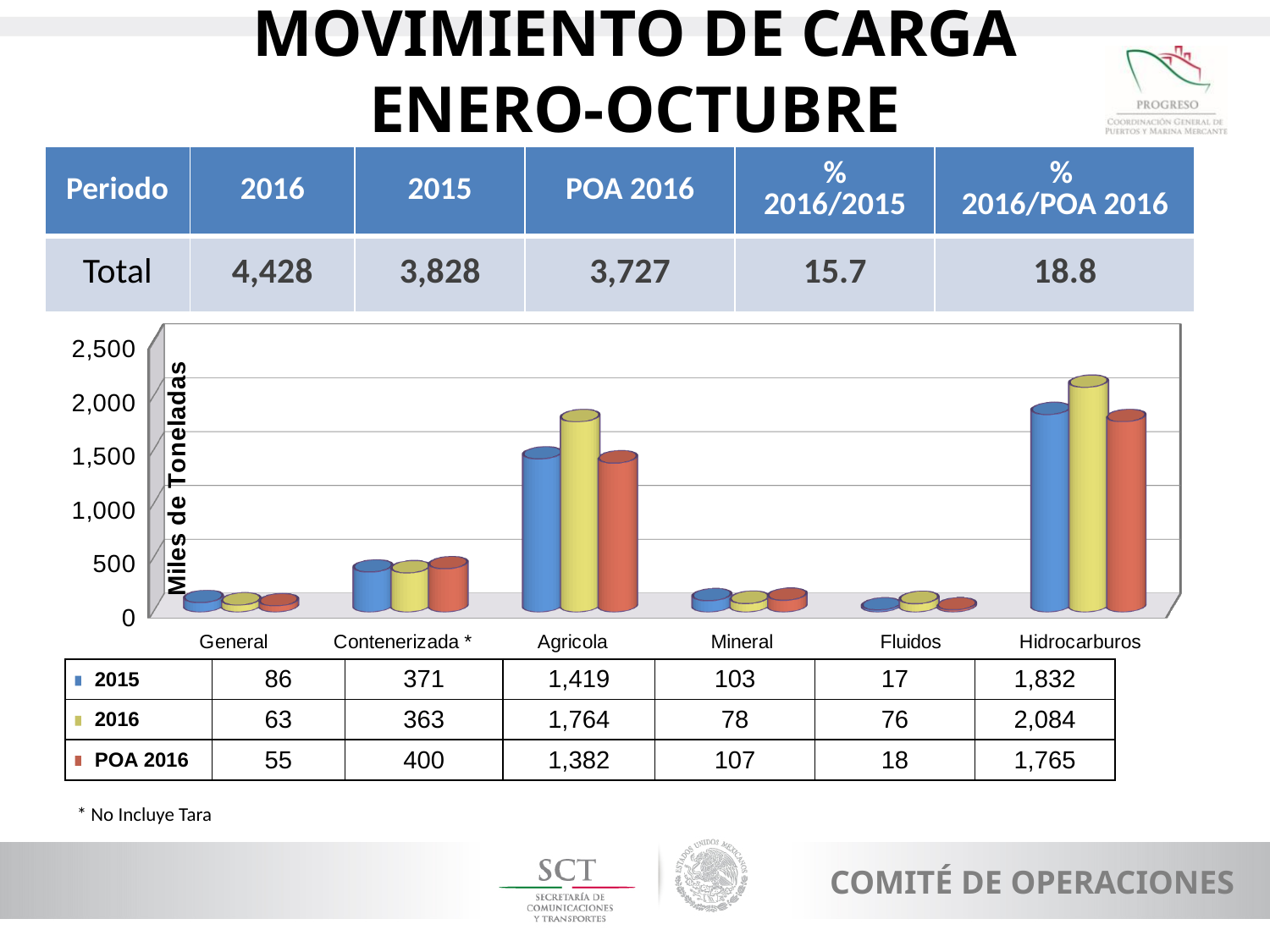
Which is larger for Mineral, the 2015 value or the 2016 value? 2015 What is the 2015 value for Fluidos? 17 What kind of chart is shown on the slide? bar chart How many series does the chart's legend list? 3 What is the 2016 value for Agricola? 1,764 How many categories are shown on the x axis of the chart? 6 Which category has the highest 2016 value? Hidrocarburos What is the POA 2016 value for Contenerizada *? 400 What is the difference between the 2016 and 2015 values for Hidrocarburos? 252 What is the label on the vertical axis of the chart? Miles de Toneladas Is the 2016 value for Hidrocarburos greater or less than 2,000? greater Which category has the lowest 2015 value? Fluidos